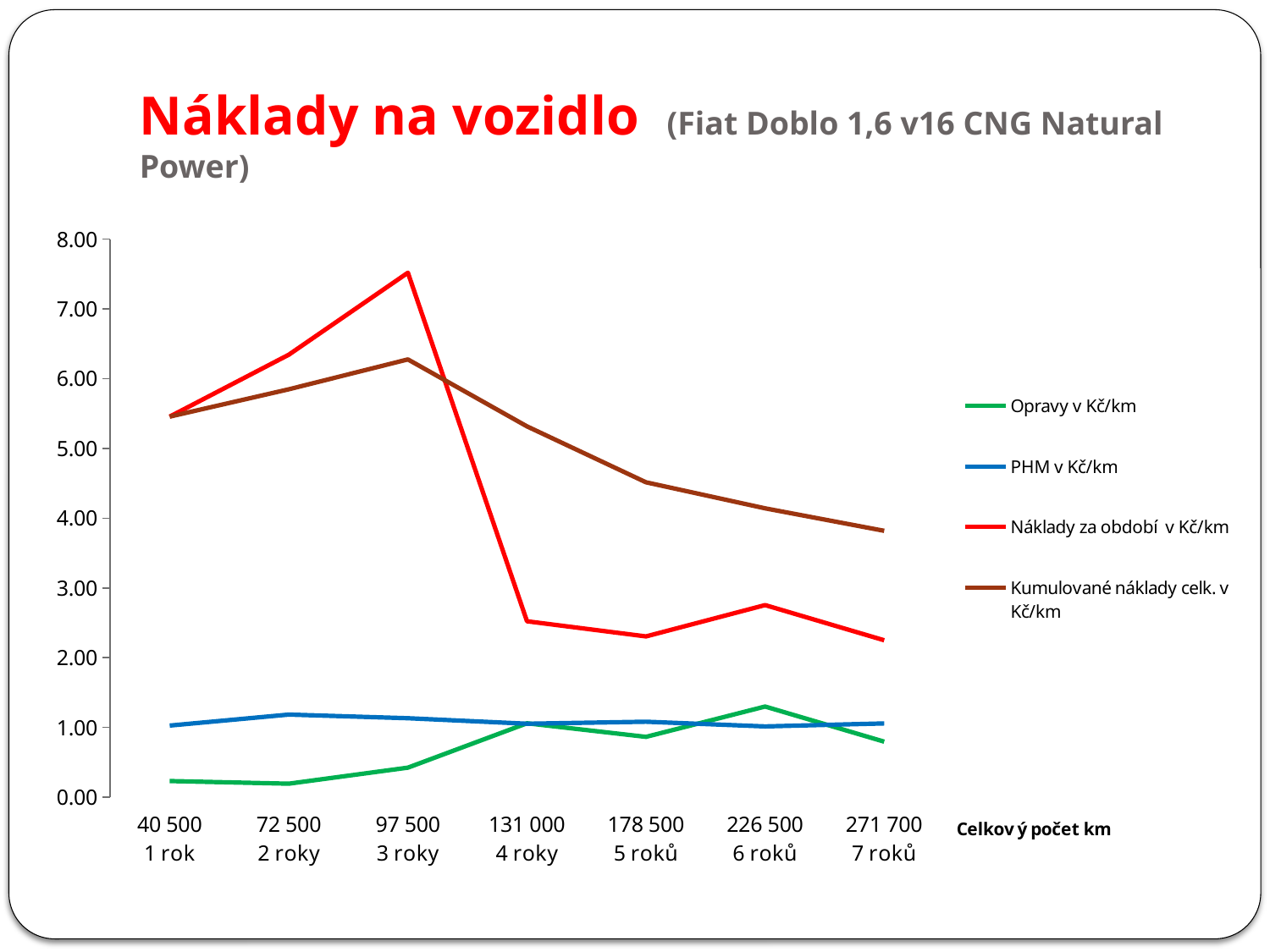
At 131 000 km (4 roky), which is higher: 'Náklady za období v Kč/km' or 'Kumulované náklady celk. v Kč/km'? Kumulované náklady celk. v Kč/km How many series does the legend list? 4 Is the value of 'Náklady za období v Kč/km' at 97 500 km (3 roky) greater or less than 7.00? greater What colour is the 'Opravy v Kč/km' line? green Is the value of 'Opravy v Kč/km' at 40 500 km (1 rok) greater or less than 1.00? less Is the value of 'Kumulované náklady celk. v Kč/km' at 97 500 km (3 roky) greater or less than 6.00? greater At which x-axis category does the 'Náklady za období v Kč/km' line reach its highest value? 97 500 / 3 roky Does the 'Kumulované náklady celk. v Kč/km' line rise or fall from 97 500 km to 271 700 km? fall What kind of chart is shown on the slide? line chart At 226 500 km (6 roků), which is higher: 'Opravy v Kč/km' or 'PHM v Kč/km'? Opravy v Kč/km How many points along the x axis does each line have? 7